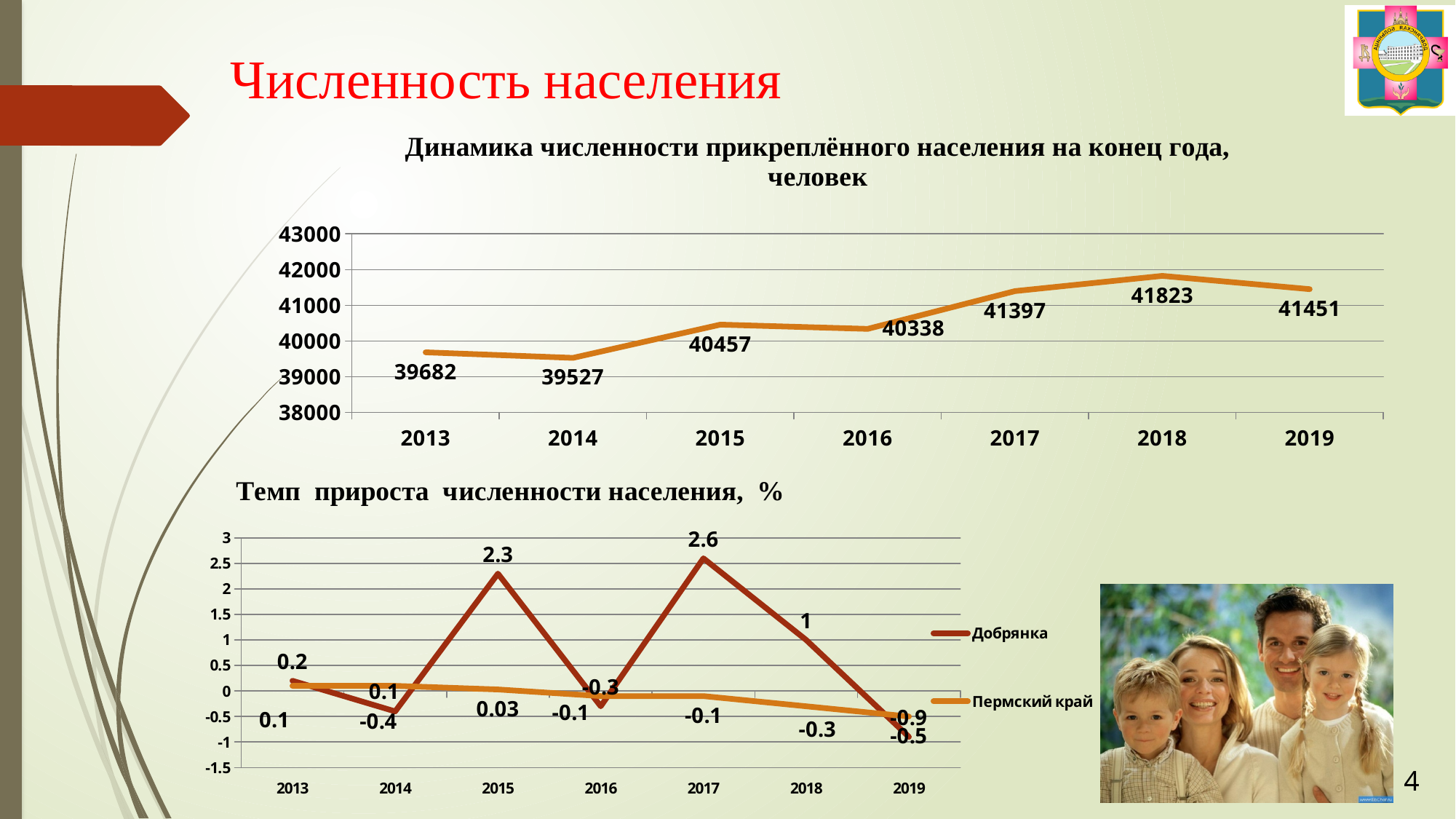
In the top chart (Динамика численности прикреплённого населения), what is the difference between the 2018 and 2019 values? 372 In the top chart (Динамика численности прикреплённого населения), what is the value for 2013? 39682 In the top chart (Динамика численности прикреплённого населения), what is the value for 2018? 41823 In the top chart (Динамика численности прикреплённого населения), which year has the lowest value? 2014 In the top chart (Динамика численности прикреплённого населения), how many years are plotted? 7 In the bottom chart (Темп прироста численности населения, %), which year has the lowest value for Добрянка? 2019 In the top chart (Динамика численности прикреплённого населения), which year has the highest value? 2018 In the bottom chart (Темп прироста численности населения, %), what is the value for Пермский край in 2019? -0.5 In the bottom chart (Темп прироста численности населения, %), what is the value for Добрянка in 2017? 2.6 In the bottom chart (Темп прироста численности населения, %), which series has the larger value in 2015, Добрянка or Пермский край? Добрянка In the bottom chart (Темп прироста численности населения, %), how many series does the legend list? 2 What kind of chart is the top chart (Динамика численности прикреплённого населения)? Line chart